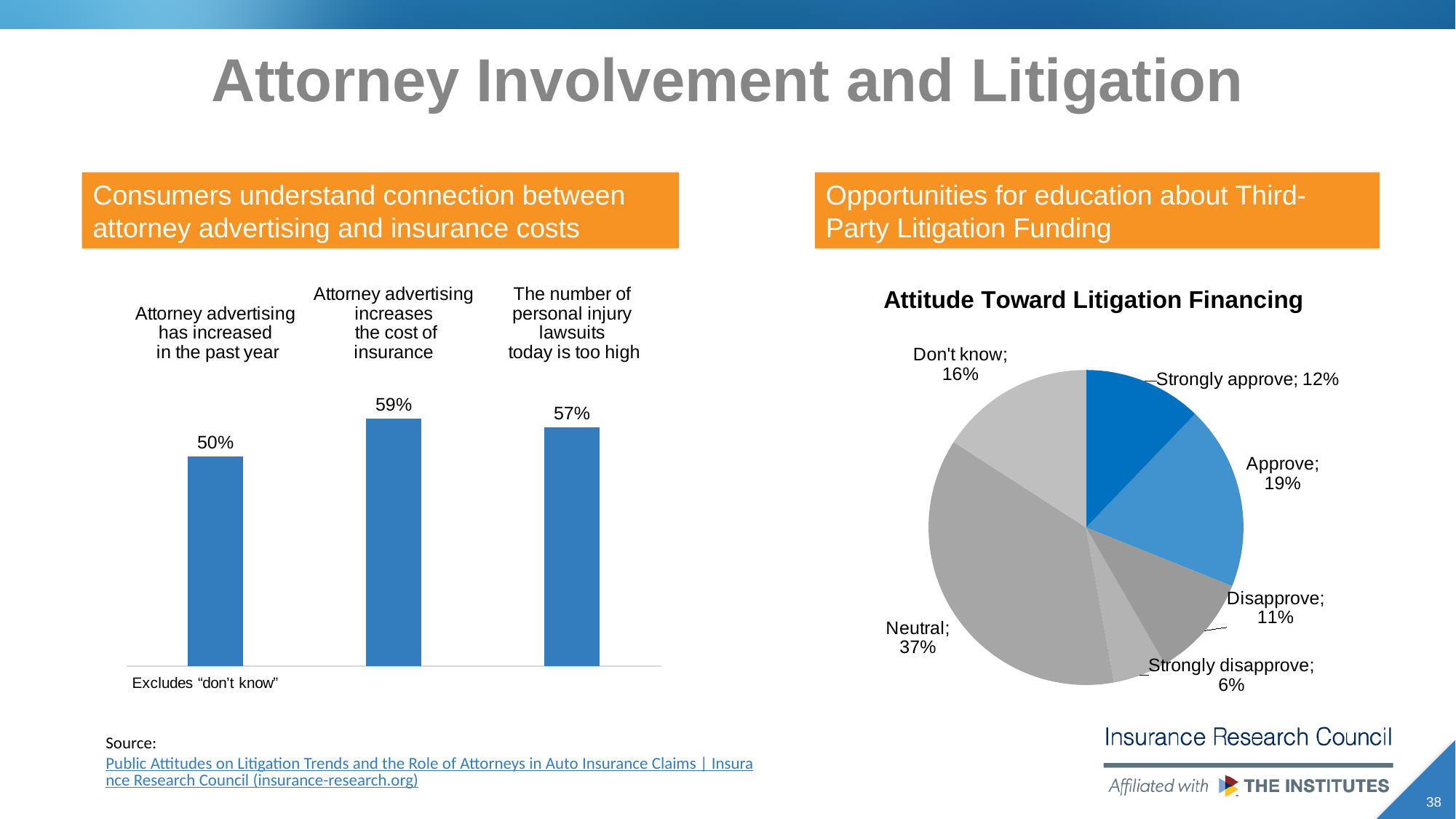
In the bar chart on the left, what percentage agree that attorney advertising has increased in the past year? 50% In the 'Attitude Toward Litigation Financing' pie chart, which is larger: Approve or Don't know? Approve In the bar chart on the left, how many bars are shown? 3 In the 'Attitude Toward Litigation Financing' pie chart, what share is Strongly disapprove? 6% In the bar chart on the left, which statement has the highest percentage? Attorney advertising increases the cost of insurance In the 'Attitude Toward Litigation Financing' pie chart, how many slices are there? 6 In the bar chart on the left, what is the difference between the percentage for 'Attorney advertising increases the cost of insurance' and 'The number of personal injury lawsuits today is too high'? 2% In the 'Attitude Toward Litigation Financing' pie chart, which slice is the largest? Neutral In the 'Attitude Toward Litigation Financing' pie chart, what share is Neutral? 37% What kind of chart is the 'Attitude Toward Litigation Financing' chart? Pie chart In the bar chart on the left, what percentage agree that attorney advertising increases the cost of insurance? 59% In the bar chart on the left, which statement has the lowest percentage? Attorney advertising has increased in the past year